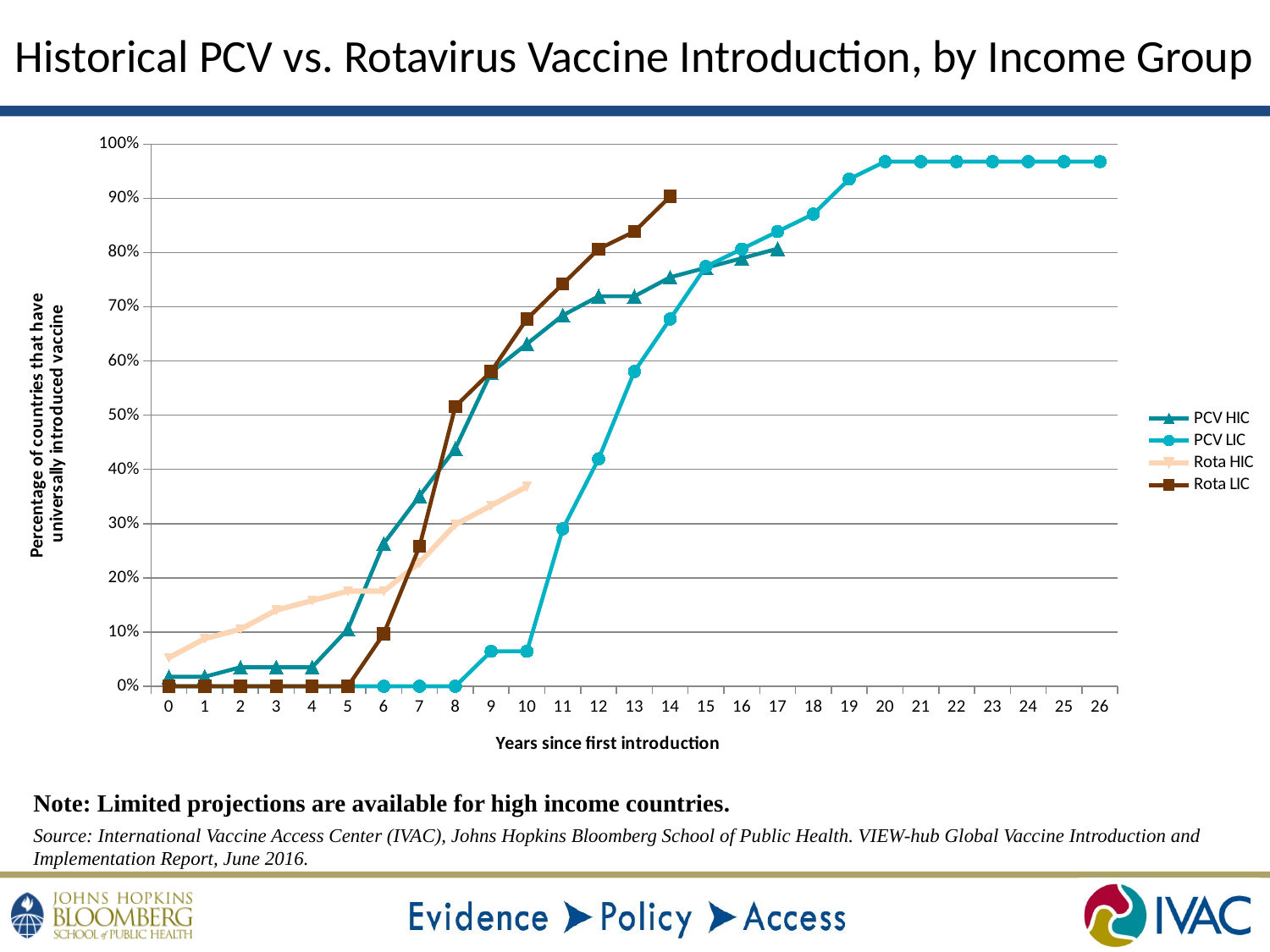
Is the value for PCV LIC at 13 years since first introduction greater or less than 50%? greater What kind of chart is shown on the slide? line chart At 13 years since first introduction, which is larger: Rota LIC or PCV HIC? Rota LIC How many series does the legend list? 4 Is the value for PCV LIC at 26 years since first introduction greater or less than 90%? greater What is the value for Rota LIC at 3 years since first introduction? 0% Does the PCV LIC series rise or fall as years since first introduction increase? rise What is the title of the x axis? Years since first introduction At 14 years since first introduction, which is larger: PCV HIC or PCV LIC? PCV HIC Which series reaches the highest percentage on the chart? PCV LIC What is the value for PCV LIC at 7 years since first introduction? 0% Is the value for Rota HIC at 10 years since first introduction greater or less than 40%? less